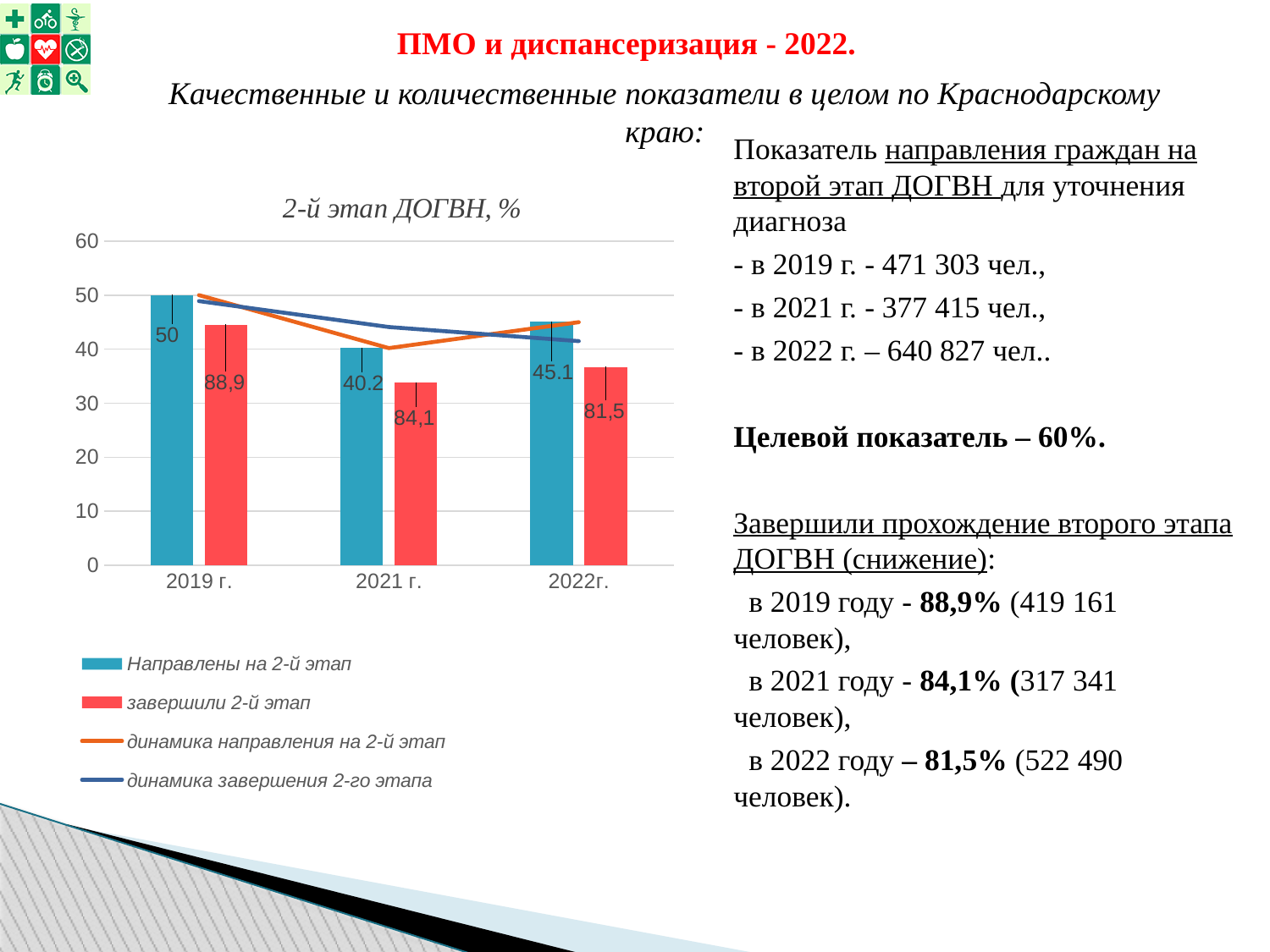
How many series does the legend list? 4 What is the difference between the 'Направлены на 2-й этап' values for 2019 г. and 2021 г.? 9.8 What is the value for 'Направлены на 2-й этап' in 2021 г.? 40.2 What data label is shown on the 'завершили 2-й этап' bar for 2021 г.? 84,1 Which is larger, the 'Направлены на 2-й этап' value for 2019 г. or for 2022г.? 2019 г. What is the value for 'Направлены на 2-й этап' in 2022г.? 45.1 How many years are shown on the x axis? 3 In which year is the 'Направлены на 2-й этап' value highest? 2019 г. What is the value for 'Направлены на 2-й этап' in 2019 г.? 50 Is the 'завершили 2-й этап' bar for 2021 г. greater or less than 40 on the axis? less In which year is the 'Направлены на 2-й этап' value lowest? 2021 г. What is the title of the chart? 2-й этап ДОГВН, %